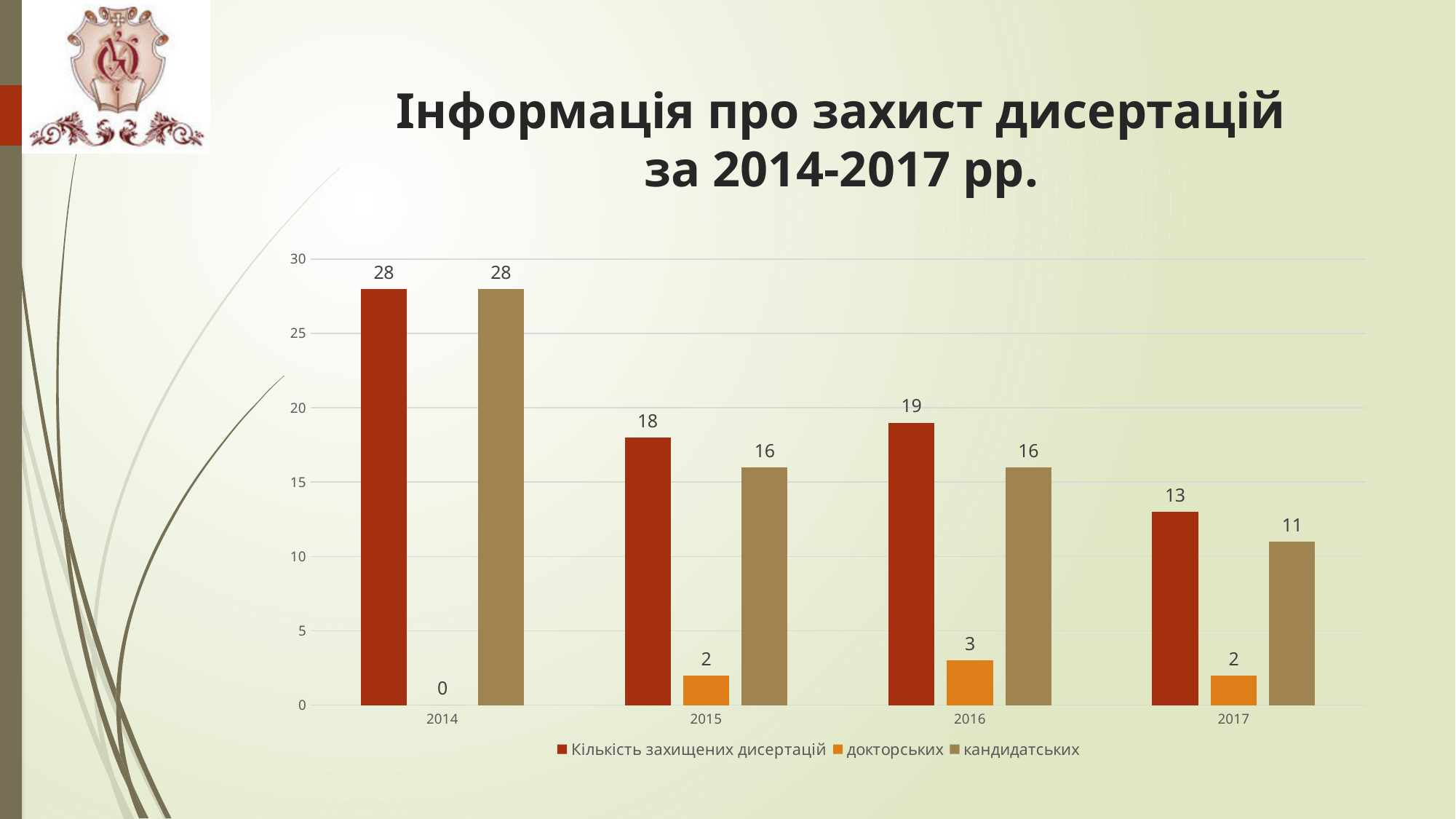
In which year was the total number of defended dissertations the highest? 2014 How many series does the legend list? 3 How many years are shown on the x axis of the chart? 4 How many doctoral dissertations (докторських) were defended in 2016? 3 How many candidate dissertations (кандидатських) were defended in 2017? 11 What is the title of the chart on the slide? Інформація про захист дисертацій за 2014-2017 рр. What is the difference between the total number of defended dissertations in 2014 and in 2017? 15 In which year was the total number of defended dissertations the lowest? 2017 Does the number of candidate dissertations (кандидатських) rise or fall from 2014 to 2017? Fall What kind of chart is shown on the slide? Bar chart What was the total number of defended dissertations (Кількість захищених дисертацій) in 2014? 28 Which is larger: the number of candidate dissertations in 2015 or in 2017? 2015